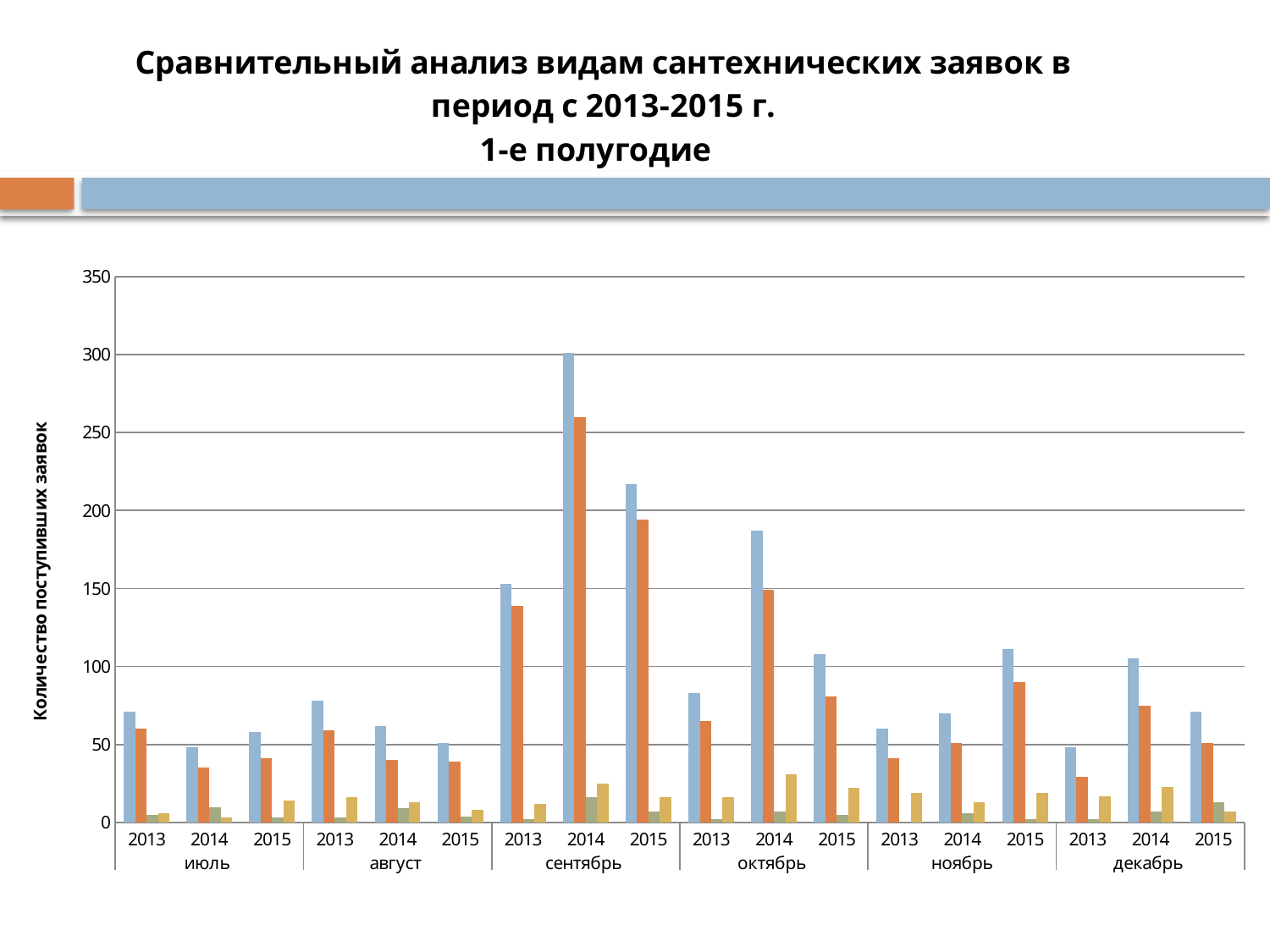
How many months are shown along the x axis of the chart? 6 Is the blue bar for сентябрь 2014 greater or less than 250? greater Is the blue bar for октябрь 2014 greater or less than 150? greater What kind of chart is shown on the slide? bar chart What is the title of the vertical axis? Количество поступивших заявок How many year groups (month-year combinations) are plotted on the chart? 18 Which is larger: the blue bar for сентябрь 2014 or the blue bar for октябрь 2014? сентябрь 2014 Is the orange bar for декабрь 2013 greater or less than 50? less Do the blue bars for ноябрь rise or fall from 2013 to 2015? rise In which month and year does the blue bar reach its highest value? сентябрь 2014 What is the highest value shown on the vertical axis? 350